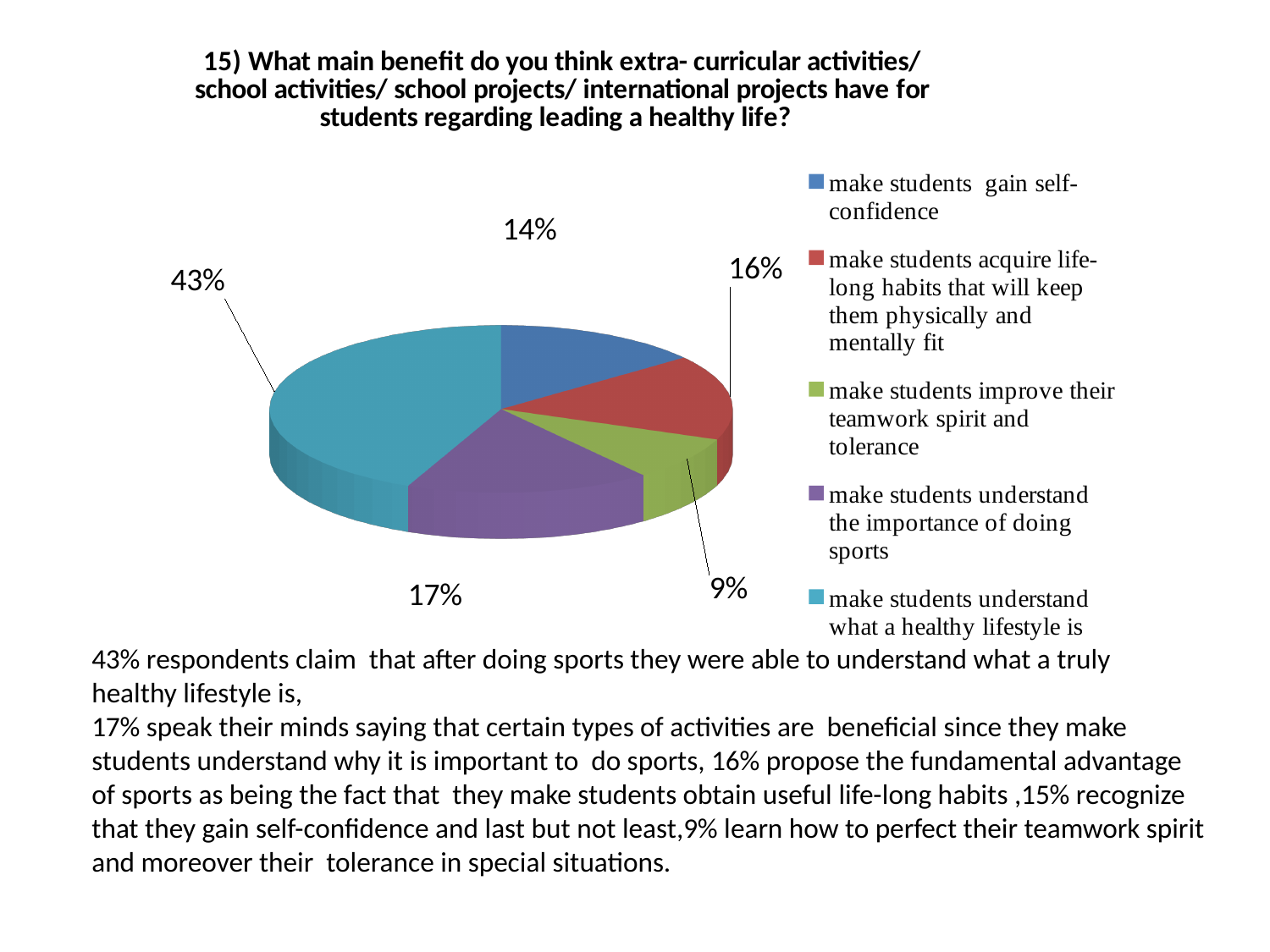
What share of the pie is labelled for "make students understand what a healthy lifestyle is"? 43% What kind of chart is shown on the slide? pie chart What colour is the slice for "make students understand what a healthy lifestyle is"? teal Which is larger: the slice for "make students acquire life-long habits" or the slice for "make students gain self-confidence"? make students acquire life-long habits What percentage is shown for "make students gain self-confidence"? 14% What percentage is shown for "make students acquire life-long habits that will keep them physically and mentally fit"? 16% What percentage is shown for "make students improve their teamwork spirit and tolerance"? 9% What is the difference in percentage points between "make students understand what a healthy lifestyle is" and "make students understand the importance of doing sports"? 26 How many categories does the legend list? 5 Which category has the smallest slice of the pie? make students improve their teamwork spirit and tolerance Which category has the largest slice of the pie? make students understand what a healthy lifestyle is What percentage is shown for "make students understand the importance of doing sports"? 17%